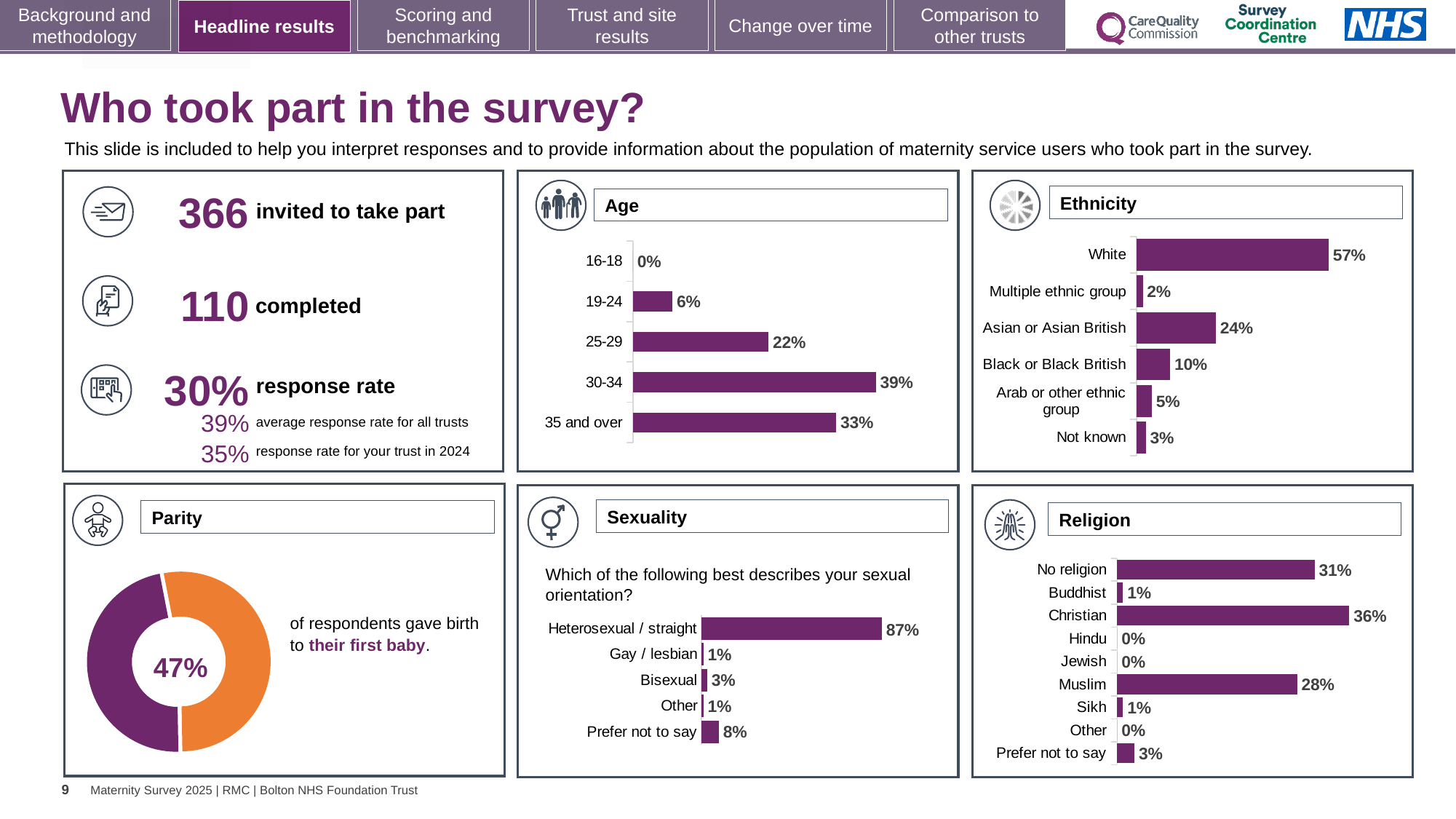
In the Age chart, what percentage of respondents were aged 30-34? 39% In the Age chart, what is the difference between the 30-34 and 25-29 percentages? 17% What kind of chart is the Parity chart? Doughnut chart In the Religion chart, which religion category has the highest percentage? Christian In the Religion chart, what is the difference between the Christian and Muslim percentages? 8% In the Parity chart, what percentage of respondents gave birth to their first baby? 47% In the Ethnicity chart, which category has the lowest percentage? Multiple ethnic group In the Ethnicity chart, how many ethnicity categories are shown? 6 In the Sexuality chart, what percentage of respondents answered Prefer not to say? 8% In the Age chart, which age group has the highest percentage? 30-34 In the Ethnicity chart, which is larger: Asian or Asian British or Black or Black British? Asian or Asian British In the Ethnicity chart, what percentage of respondents were White? 57%